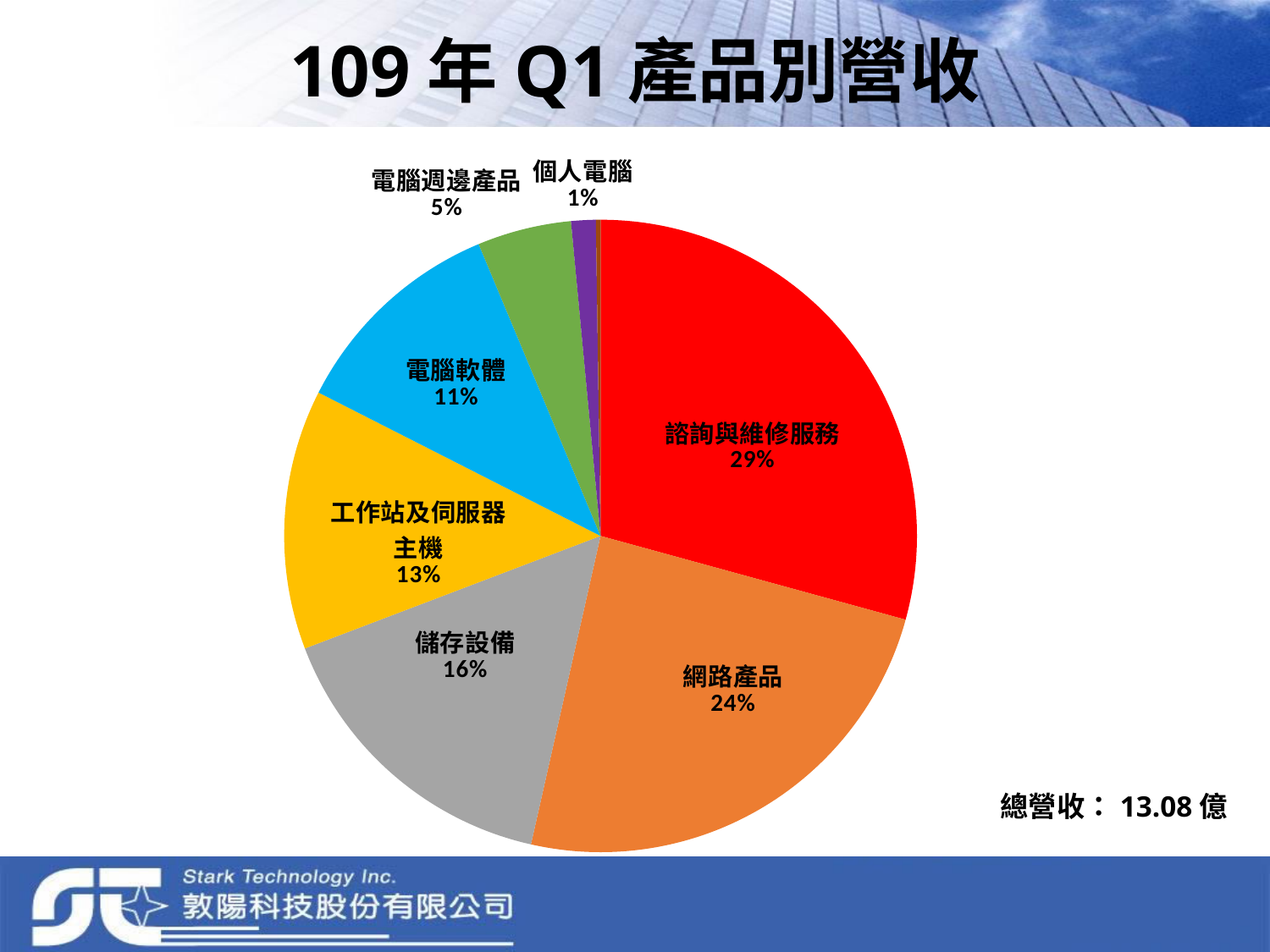
Which labeled product category has the smallest share of revenue? 個人電腦 What kind of chart is shown on the slide? Pie chart Which product category has the largest share of revenue? 諮詢與維修服務 What percentage is shown for 工作站及伺服器主機? 13% What is the difference in percentage points between 諮詢與維修服務 and 網路產品? 5 What percentage is shown for 電腦軟體? 11% What percentage is shown for 儲存設備? 16% What share of revenue does 諮詢與維修服務 account for in the pie chart? 29% What percentage is shown for 個人電腦? 1% What is the title of the chart on the slide? 109 年 Q1 產品別營收 What percentage is shown for 網路產品? 24% Which has a larger share, 儲存設備 or 電腦軟體? 儲存設備